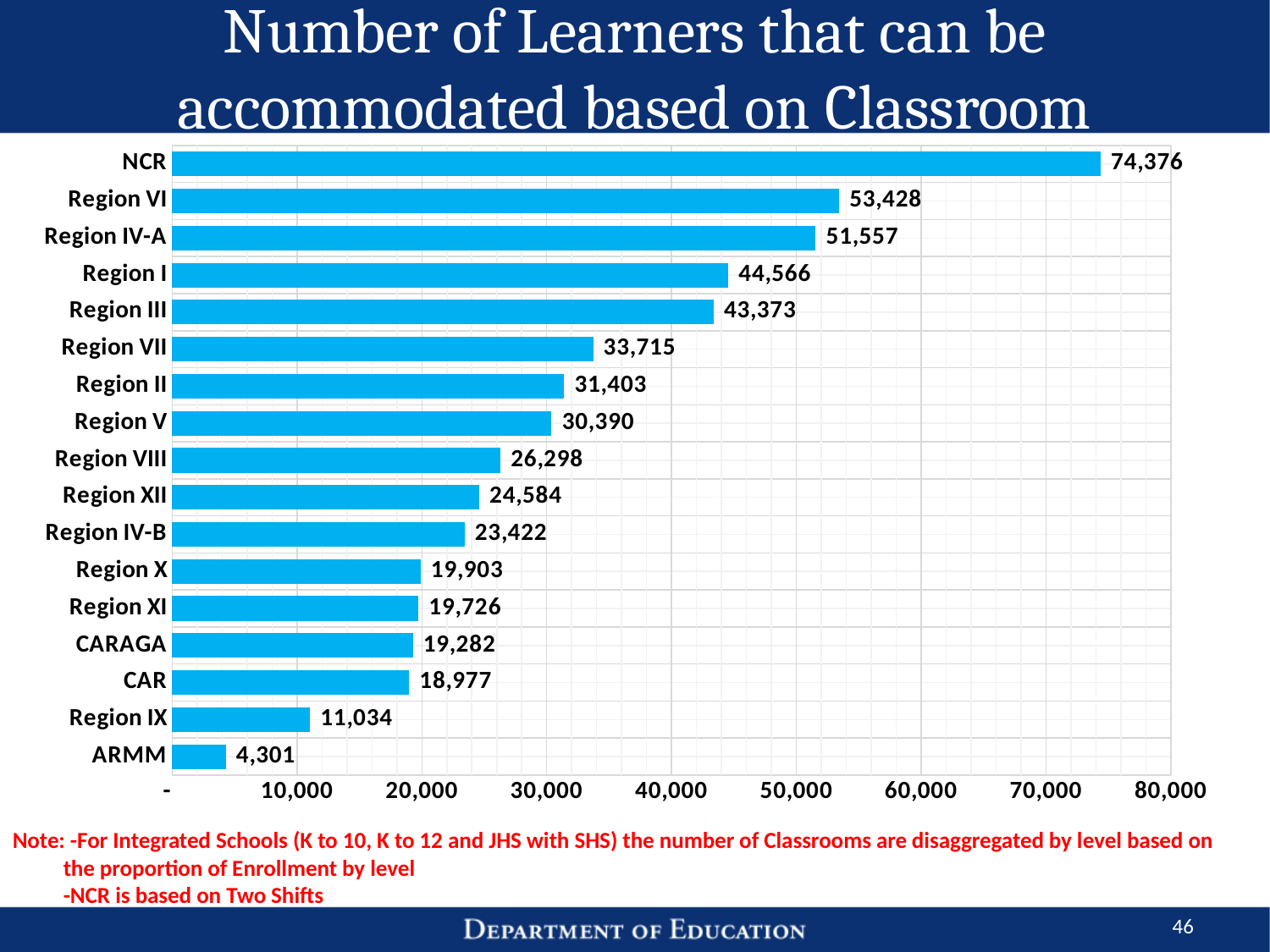
What is the value shown for Region IX? 11,034 Which region has the highest number of learners that can be accommodated? NCR Which region has the lowest number of learners that can be accommodated? ARMM Which has a larger value, Region VII or Region V? Region VII What type of chart is shown on the slide? Bar chart What is the maximum value shown on the horizontal axis? 80,000 What is the value shown for CARAGA? 19,282 Is the value for Region IV-A greater or less than 50,000? greater What is the difference between the values for Region I and Region III? 1,193 How many regions are shown in the chart? 17 What is the number of learners that can be accommodated in Region VI? 53,428 What is the difference between the values for NCR and Region VI? 20,948